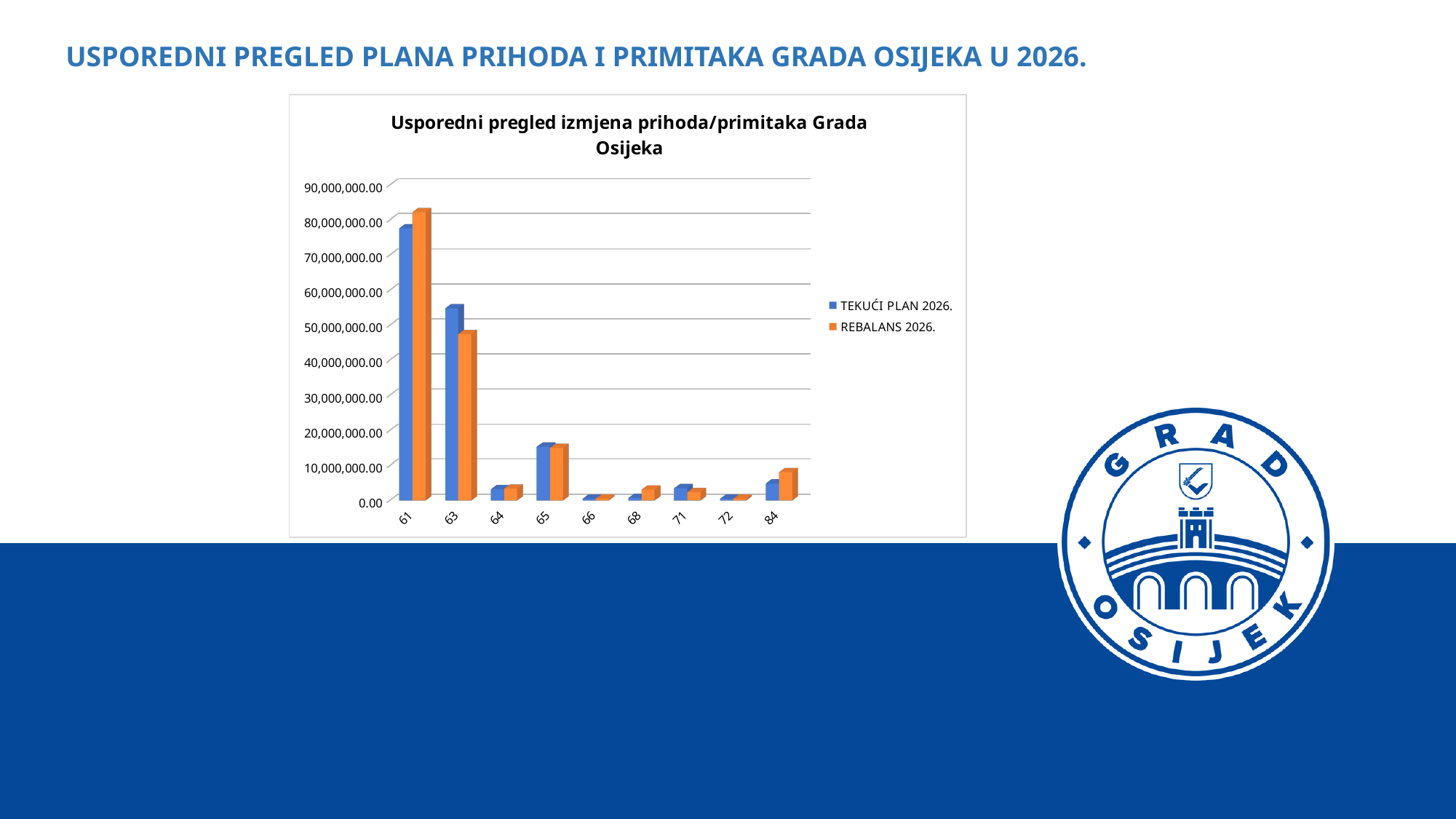
Is the TEKUĆI PLAN 2026. value for category 61 greater or less than 70,000,000.00? greater How many series does the legend list? 2 Is the REBALANS 2026. value for category 63 greater or less than 50,000,000.00? less Which category has the highest value for TEKUĆI PLAN 2026.? 61 What kind of chart is shown on the slide? bar chart For category 61, which series has the larger value, TEKUĆI PLAN 2026. or REBALANS 2026.? REBALANS 2026. Is the TEKUĆI PLAN 2026. value for category 65 greater or less than 10,000,000.00? greater Which category has the highest value for REBALANS 2026.? 61 What are the two series named in the legend? TEKUĆI PLAN 2026. and REBALANS 2026. For category 63, which series has the larger value, TEKUĆI PLAN 2026. or REBALANS 2026.? TEKUĆI PLAN 2026. How many categories are shown on the x axis? 9